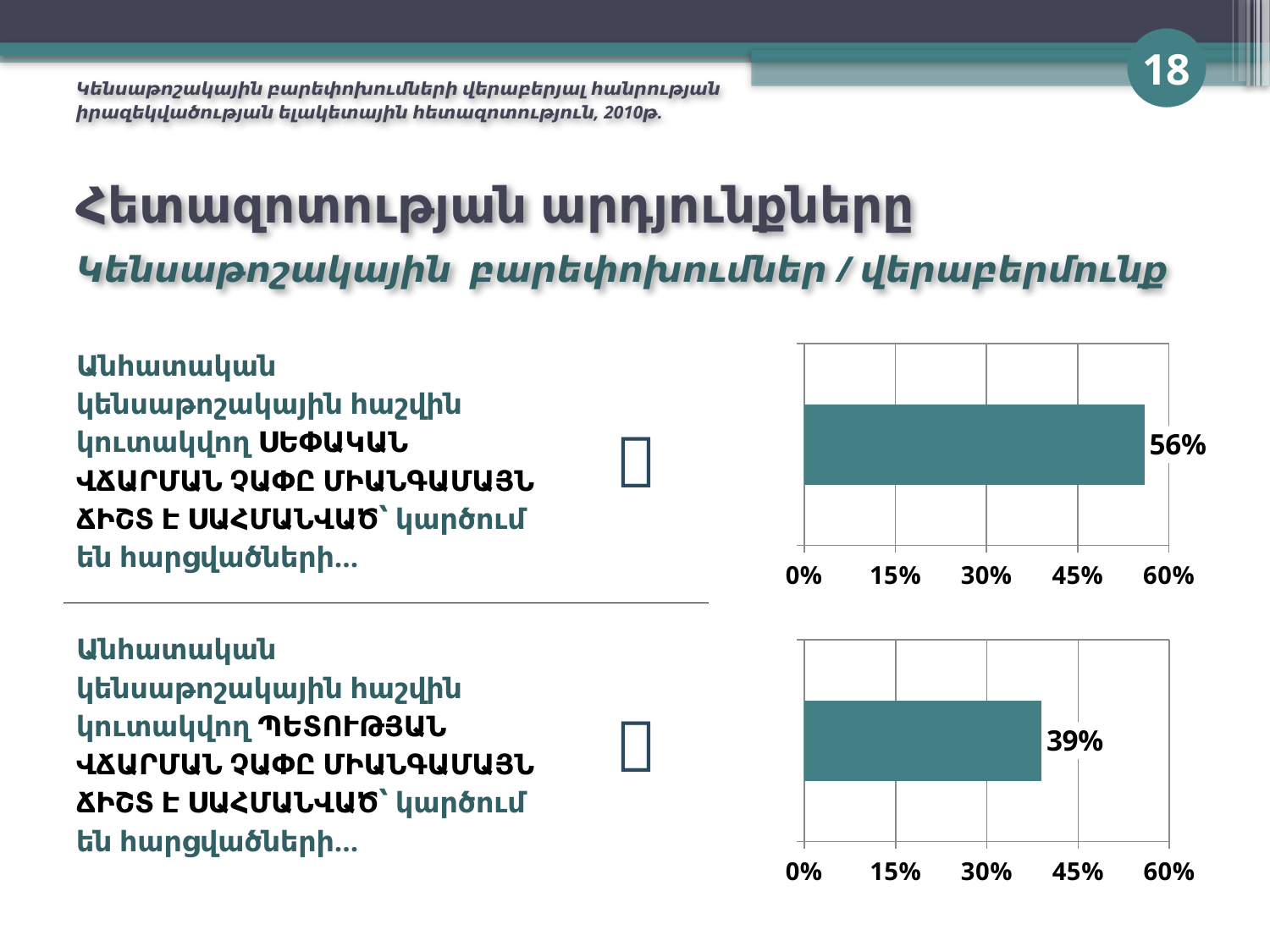
What is the difference between the value in the top chart (56%) and the value in the bottom chart (39%)? 17% In the bottom chart, is the value of the bar greater or less than 45%? less What value is shown by the bar in the bottom chart on the slide? 39% How many bars are plotted in the bottom chart? 1 Which chart shows the larger value, the top chart or the bottom chart? the top chart How many tick labels are shown on the x axis of the bottom chart? 5 What value is shown by the bar in the top chart on the slide? 56% What is the highest value labelled on the x axis of the top chart? 60% In the top chart, is the value of the bar greater or less than 45%? greater In the bottom chart, is the value of the bar greater or less than 30%? greater What kind of chart is the top chart on the slide? bar chart